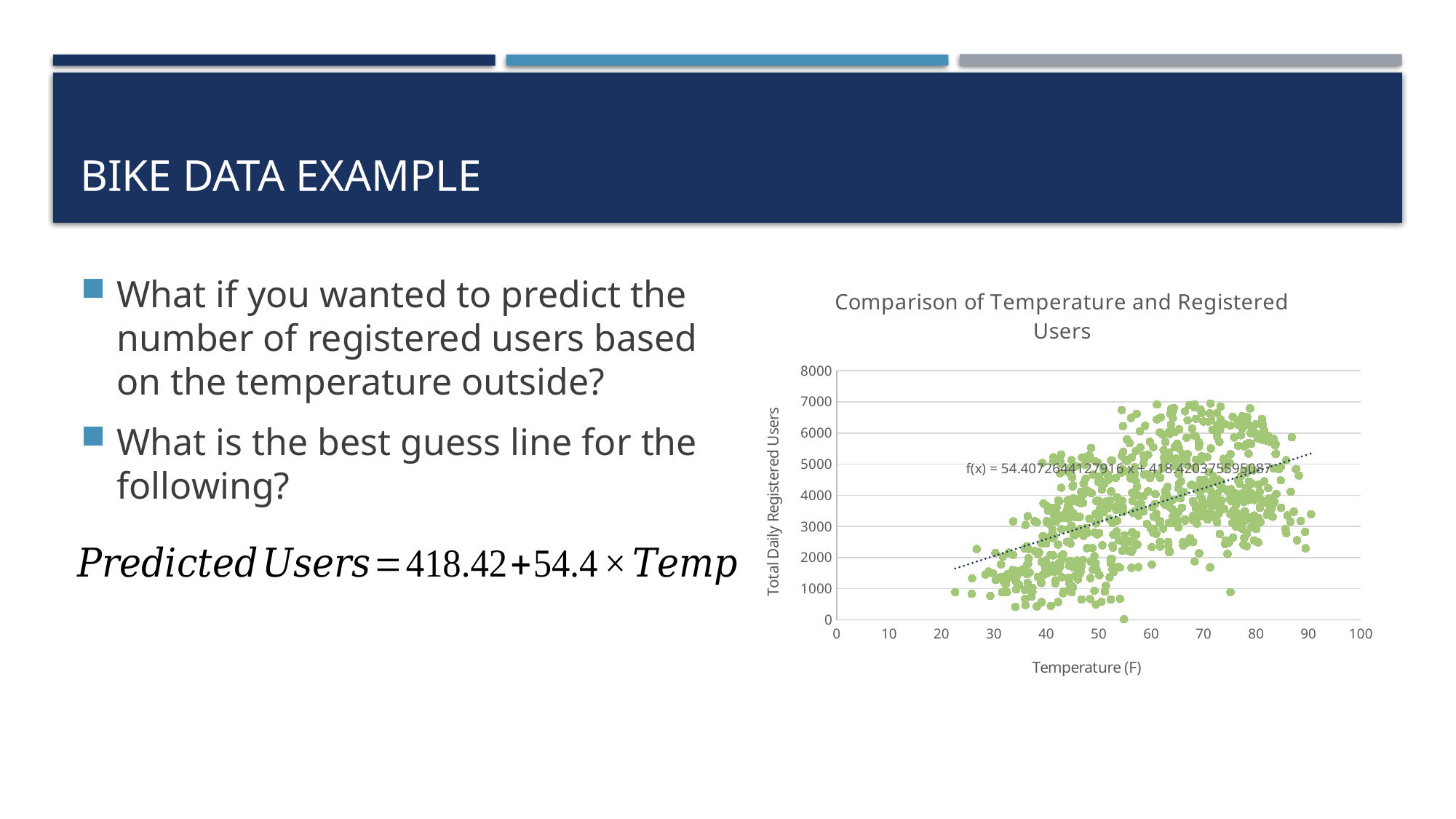
What is the highest tick value shown on the x axis of the chart? 100 What is the title of the chart on the slide? Comparison of Temperature and Registered Users As temperature increases along the x axis, do the registered user values generally rise or fall? Rise What kind of chart is shown on the slide? Scatter chart What is the intercept in the trendline equation printed on the chart? 418.420375595087 Does the dotted trendline on the chart slope upward or downward from left to right? Upward What is the highest tick value shown on the y axis of the chart? 8000 Is the highest temperature plotted on the chart greater or less than 80? greater What is the label of the x axis of the chart? Temperature (F) Is the lowest temperature plotted on the chart greater or less than 30? less Is the highest registered users value plotted greater or less than 8000? less What is the slope (coefficient of x) in the trendline equation printed on the chart? 54.4072644127916